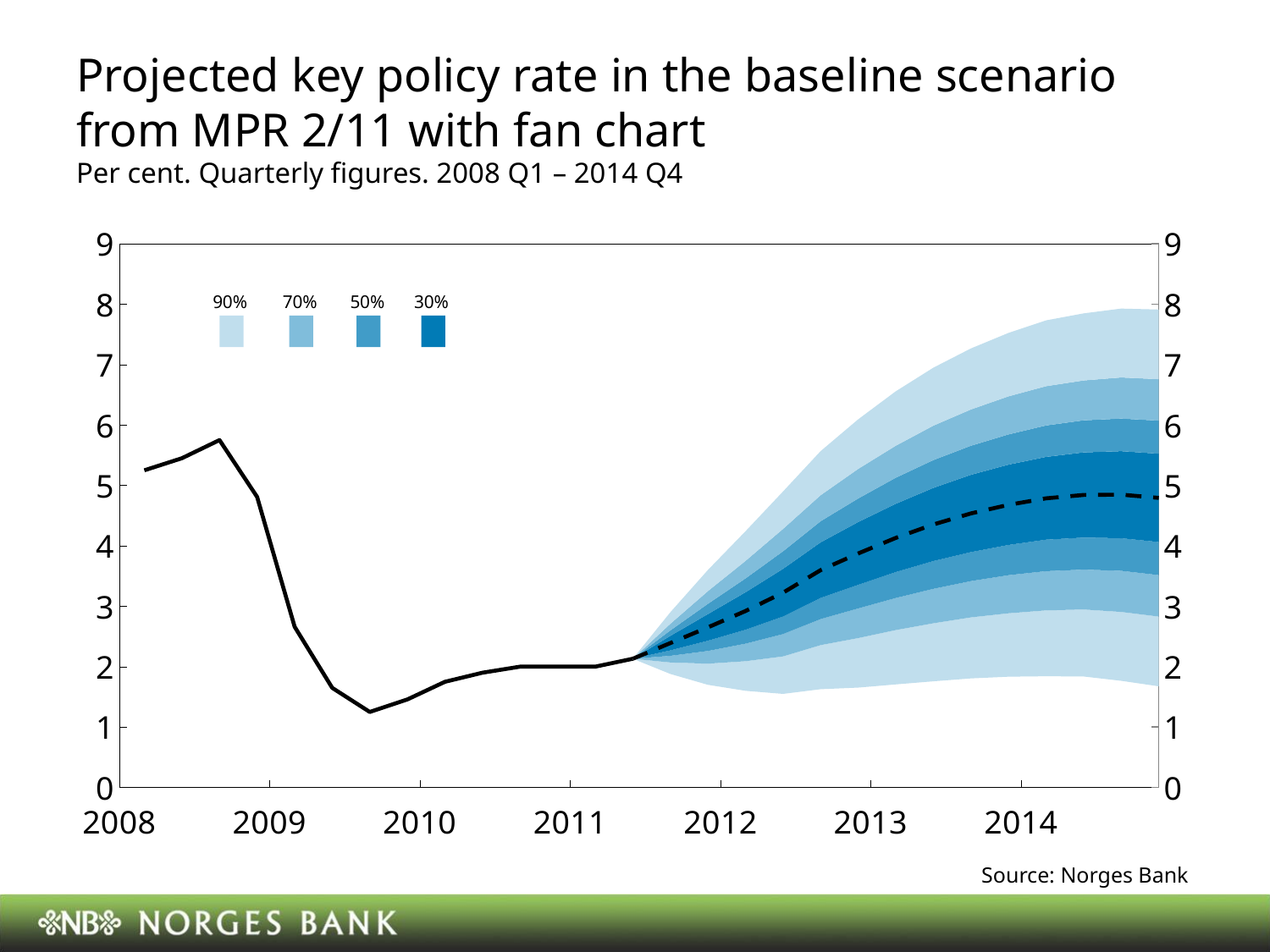
What is the highest value shown on the vertical axis? 9 How many probability bands does the fan chart legend list? 4 Which year is the first label on the horizontal axis? 2008 Does the projected key policy rate rise or fall from 2012 to 2014? rise What kind of chart is shown on the slide? line chart Is the projected key policy rate at the end of 2014 greater or less than 4? greater Does the key policy rate rise or fall between late 2008 and late 2009? fall Which probability bands are listed in the fan chart legend? 90%, 70%, 50%, 30% Is the key policy rate at the start of 2008 greater or less than 4? greater Is the lowest point of the key policy rate in 2009 greater or less than 2? less